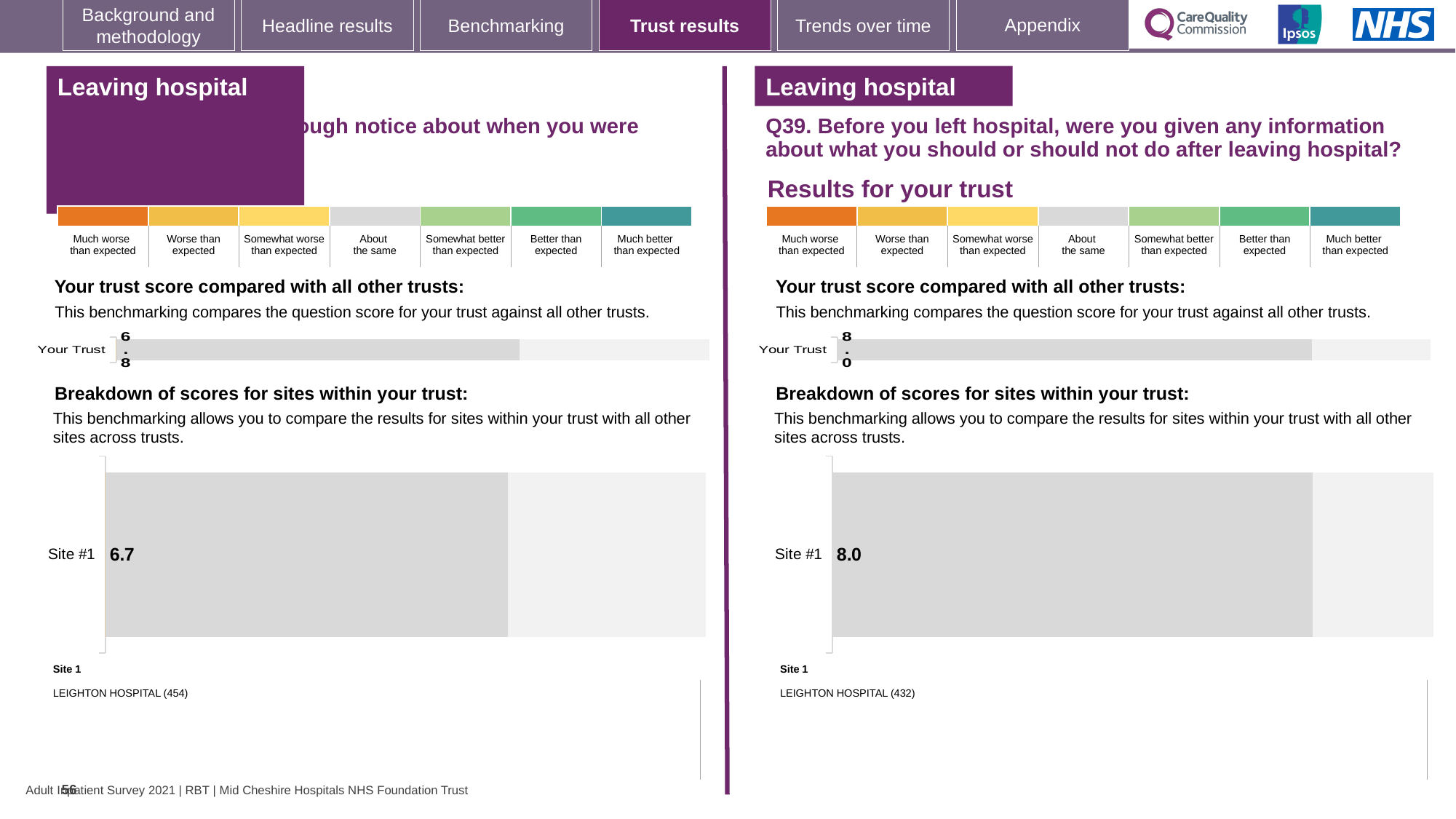
On the left half of the slide, what is the value shown for Your Trust in the trust score bar chart? 6.8 What is the difference between the Site #1 score for Q39 on the right half and the Site #1 score on the left half of the slide? 1.3 In the site breakdown on the left half of the slide, which hospital is listed as Site 1? LEIGHTON HOSPITAL (454) In the Q39 site breakdown on the right half of the slide, which hospital is listed as Site 1? LEIGHTON HOSPITAL (432) Which is larger: the Your Trust score on the left half of the slide or the Your Trust score for Q39 on the right half? Q39 on the right half On the left half of the slide, what score is shown for Site #1 in the site breakdown bar chart? 6.7 On the left half of the slide, what is the difference between the Your Trust score and the Site #1 score? 0.1 In the Q39 chart on the right half of the slide, what is the value shown for Your Trust? 8.0 In the Q39 site breakdown chart on the right half of the slide, what score is shown for Site #1? 8.0 How many sites are shown in the Q39 site breakdown chart on the right half of the slide? 1 What type of chart is used to show the Site #1 score in the Q39 site breakdown on the right half of the slide? Bar chart